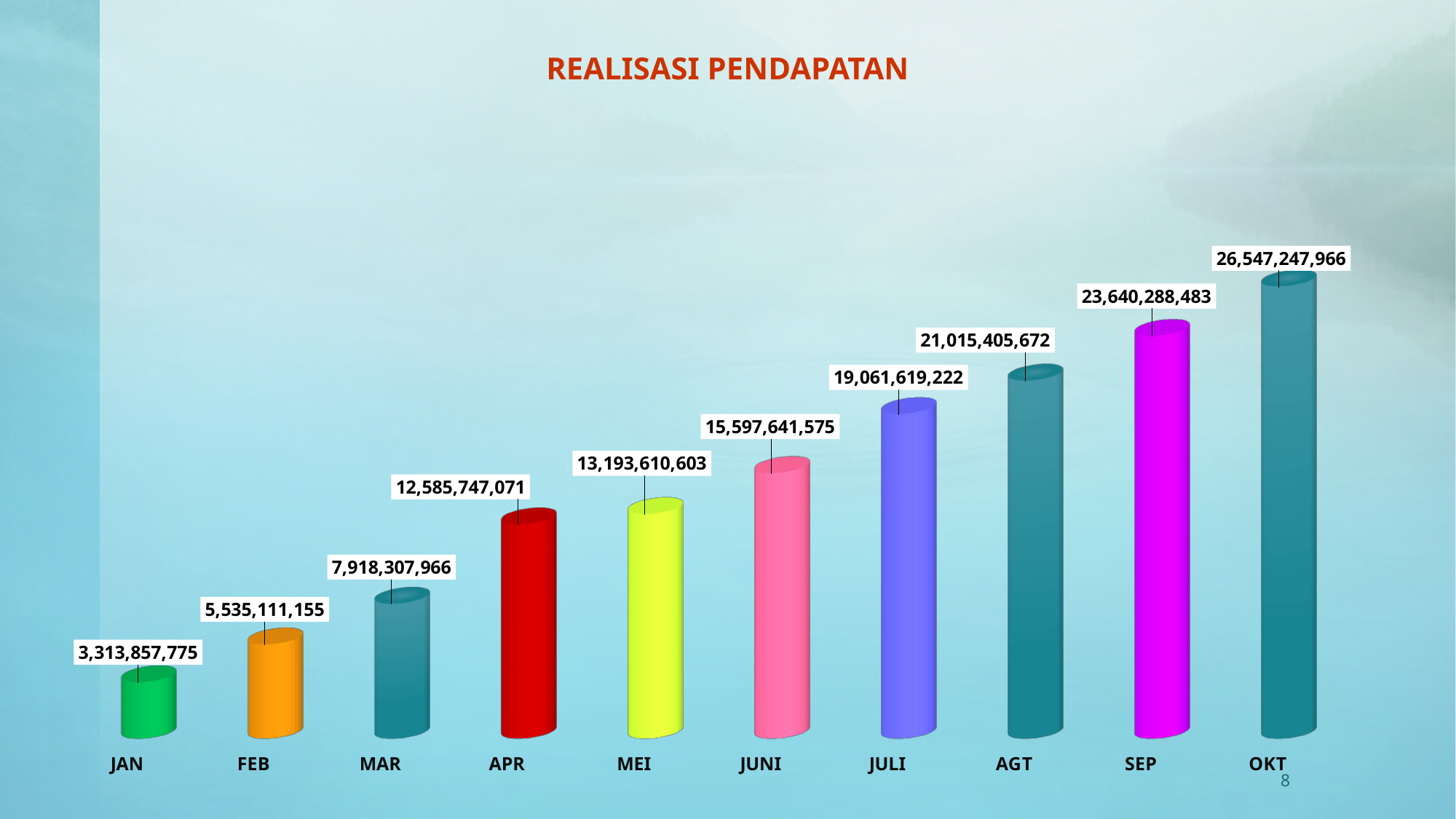
What is the value for SEP? 23,640,288,483 What is the value for JAN? 3,313,857,775 Which month has the highest value? OKT What is the difference between the values for OKT and JAN? 23,233,390,191 Which month has the lowest value? JAN What is the difference between the values for SEP and AGT? 2,624,882,811 What is the value for JUNI? 15,597,641,575 How many months are shown on the x axis? 10 Do the values rise or fall from JAN to OKT? Rise What type of chart is shown on the slide? Bar chart What is the title of the chart? REALISASI PENDAPATAN Which is larger, the value for APR or the value for MAR? APR